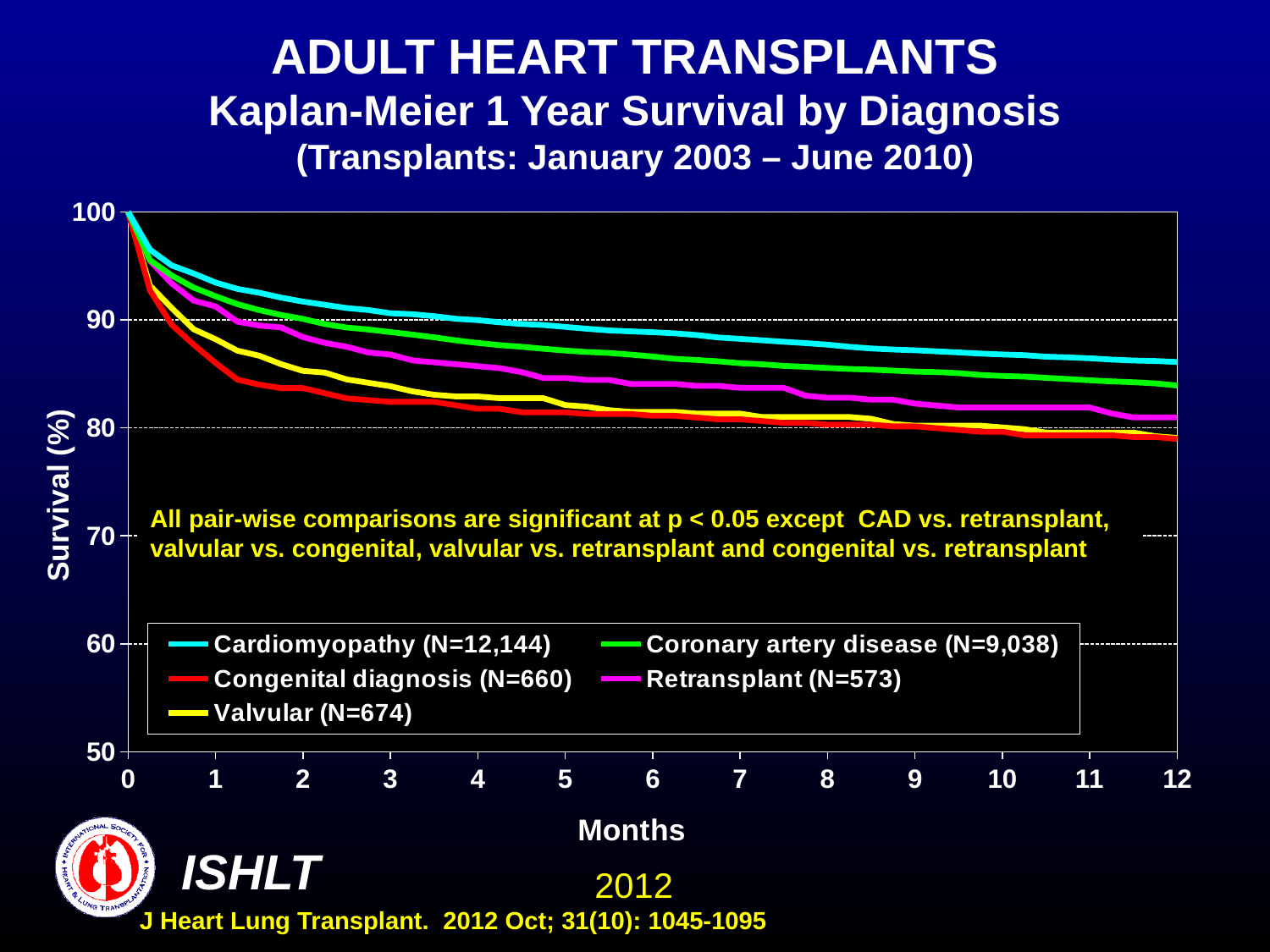
How many series does the legend list? 5 What is the N for the Cardiomyopathy group shown in the legend? 12,144 At 6 months, which has higher survival: Cardiomyopathy or Retransplant? Cardiomyopathy What is the label of the x axis? Months Is the survival for Congenital diagnosis at 12 months greater or less than 80? less Which diagnosis group has the highest survival at 12 months? Cardiomyopathy What is the N for the Retransplant group shown in the legend? 573 Is the survival for Cardiomyopathy at 12 months greater or less than 80? greater Is the survival for Congenital diagnosis at 1 month greater or less than 90? less Do the survival curves rise or fall as months increase? Fall What kind of chart is shown on the slide? Line chart